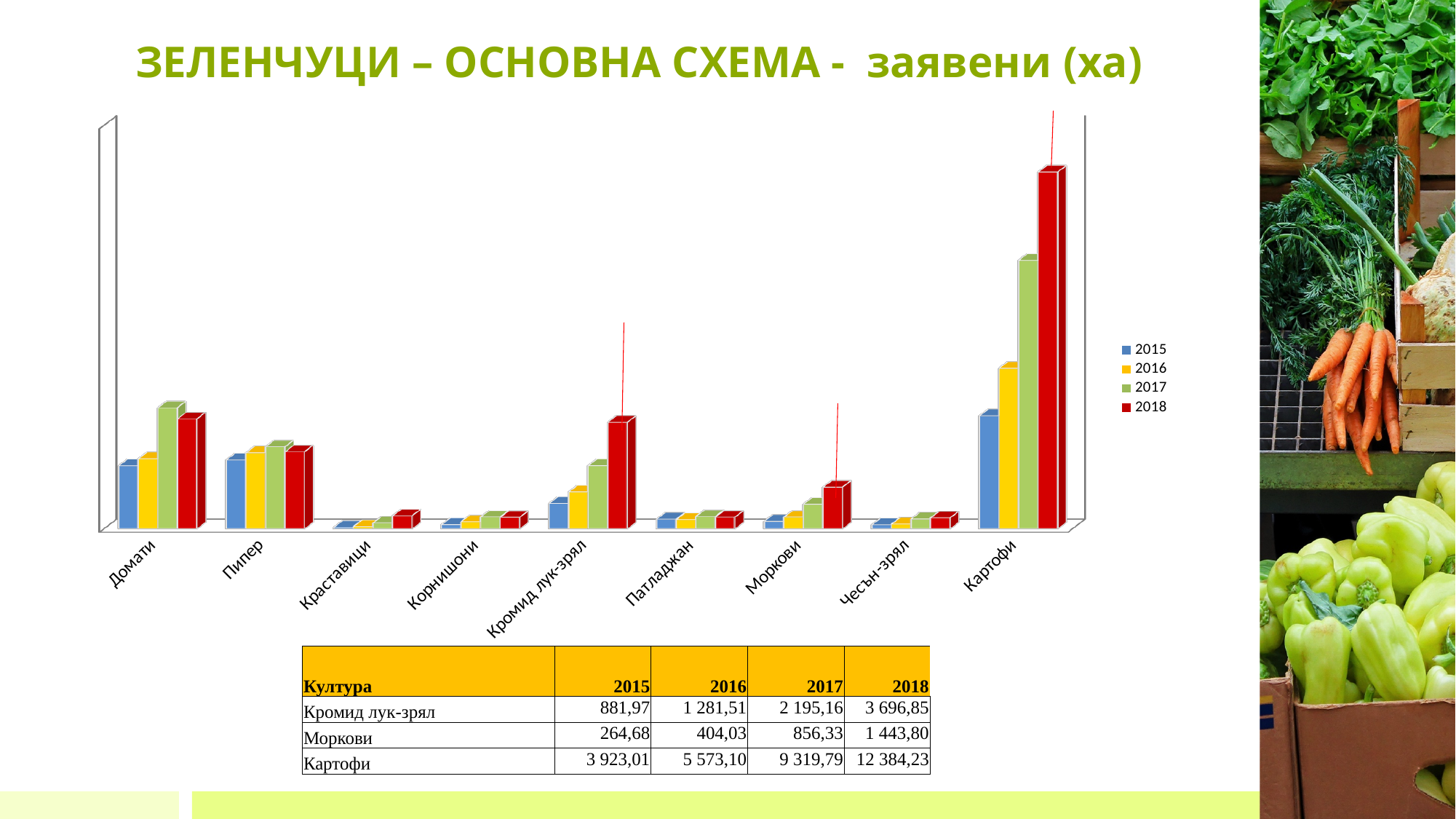
According to the table, what is the value for Моркови in 2015? 264,68 How many series does the chart legend list? 4 What kind of chart is shown on the slide? bar chart According to the table, what is the value for Кромид лук-зрял in 2017? 2 195,16 How many vegetable categories are shown on the x axis of the chart? 9 According to the table, what is the value for Картофи in 2018? 12 384,23 Which years are listed in the chart legend? 2015, 2016, 2017, 2018 What is the difference between the Моркови values for 2018 and 2017 in the table? 587,47 For Домати, which is larger: the 2015 bar or the 2017 bar? 2017 Which category has the tallest bar in the chart? Картофи What is the difference between the Картофи values for 2018 and 2017 in the table? 3 064,44 Do the values for Картофи rise or fall from 2015 to 2018? rise